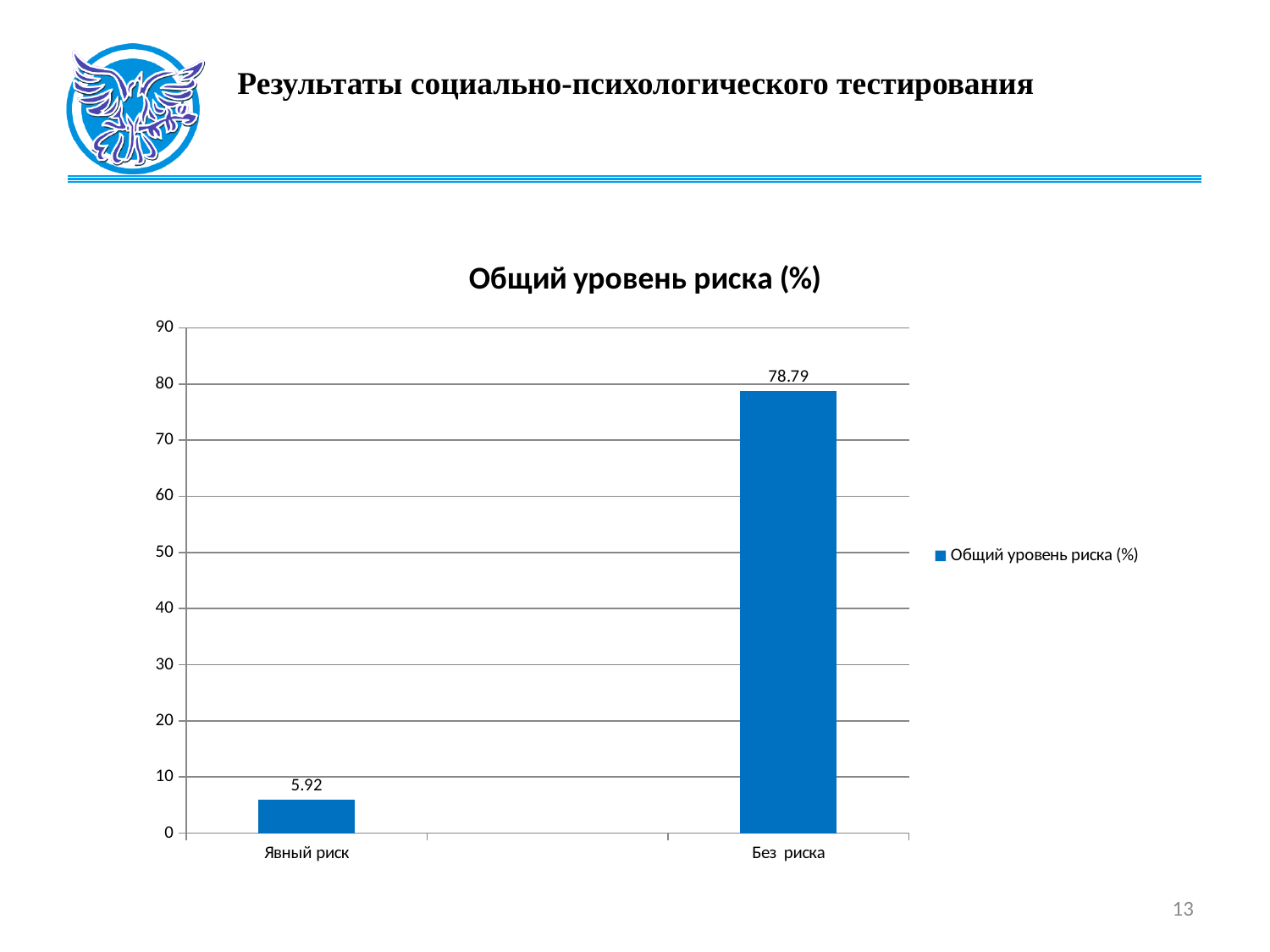
What is the title of the chart? Общий уровень риска (%) What is the value for Явный риск? 5.92 Which category has the lowest value? Явный риск How many categories are shown on the x axis? 2 What is the difference between the values for Без риска and Явный риск? 72.87 How many series does the legend list? 1 What is the value for Без риска? 78.79 Is the value for Без риска greater or less than 70? greater Which category has the highest value? Без риска Which is larger, the value for Явный риск or the value for Без риска? Без риска Is the value for Явный риск greater or less than 10? less What kind of chart is shown on the slide? bar chart